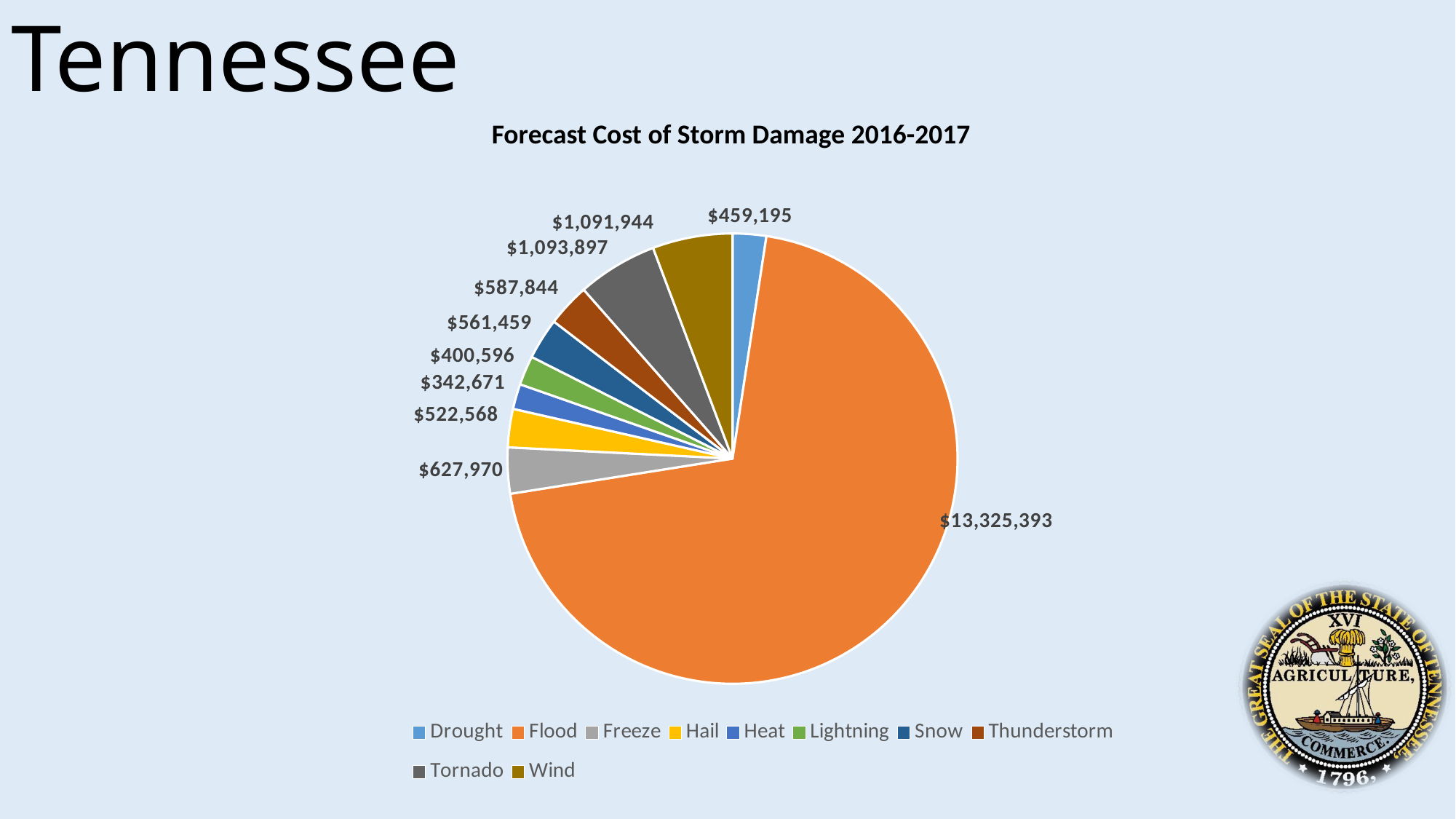
What is the forecast cost of storm damage for Flood? $13,325,393 What is the difference between the forecast cost for Tornado and for Wind? $1,953 What is the title of the chart? Forecast Cost of Storm Damage 2016-2017 What kind of chart is shown on the slide? Pie chart Which storm type has the lowest forecast cost of damage? Heat Which has a larger forecast cost, Snow or Lightning? Snow What is the difference between the forecast cost for Freeze and for Hail? $105,402 What is the forecast cost of storm damage for Tornado? $1,093,897 What is the forecast cost of storm damage for Heat? $342,671 What is the forecast cost of storm damage for Drought? $459,195 How many storm types are shown in the pie chart? 10 Which storm type has the highest forecast cost of damage? Flood